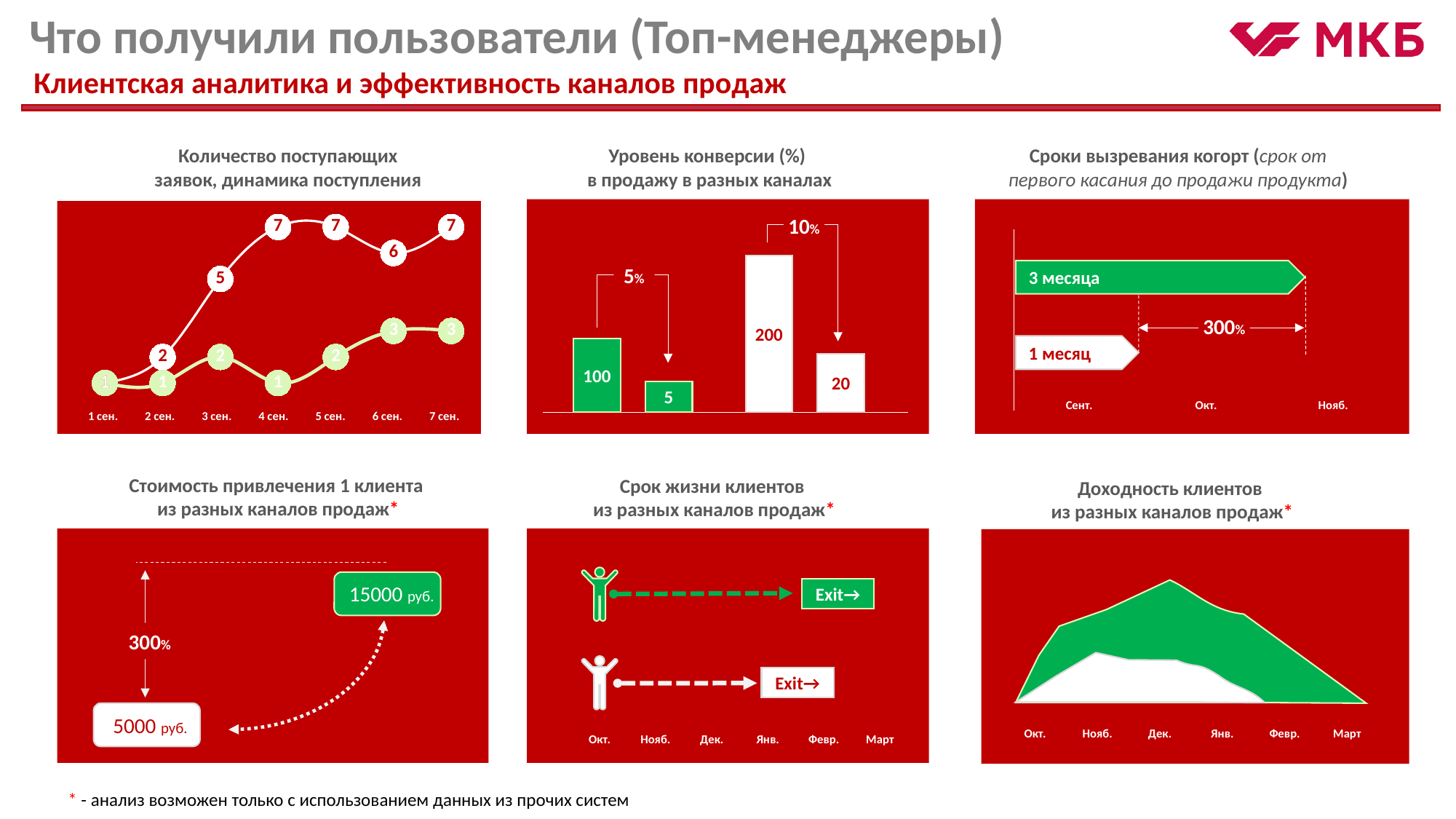
In the chart 'Количество поступающих заявок, динамика поступления', does the white series rise or fall from 1 сен. to 4 сен.? rises What kind of chart is 'Уровень конверсии (%) в продажу в разных каналах'? bar chart In the chart 'Количество поступающих заявок, динамика поступления', what is the difference between the white and green series on 3 сен.? 3 In the chart 'Количество поступающих заявок, динамика поступления', what is the value of the green series on 6 сен.? 3 In the chart 'Уровень конверсии (%) в продажу в разных каналах', what is the value of the tallest bar? 200 In the chart 'Уровень конверсии (%) в продажу в разных каналах', what is the value of the smallest bar? 5 In the chart 'Количество поступающих заявок, динамика поступления', what is the highest value reached by the white series? 7 What kind of chart is 'Количество поступающих заявок, динамика поступления'? line chart In the chart 'Доходность клиентов из разных каналов продаж', how many months are labelled on the x axis? 6 In the chart 'Количество поступающих заявок, динамика поступления', what is the value of the white series on 3 сен.? 5 In the chart 'Уровень конверсии (%) в продажу в разных каналах', what is the difference between the two white bars (200 and 20)? 180 In the chart 'Количество поступающих заявок, динамика поступления', how many dates are shown on the x axis? 7